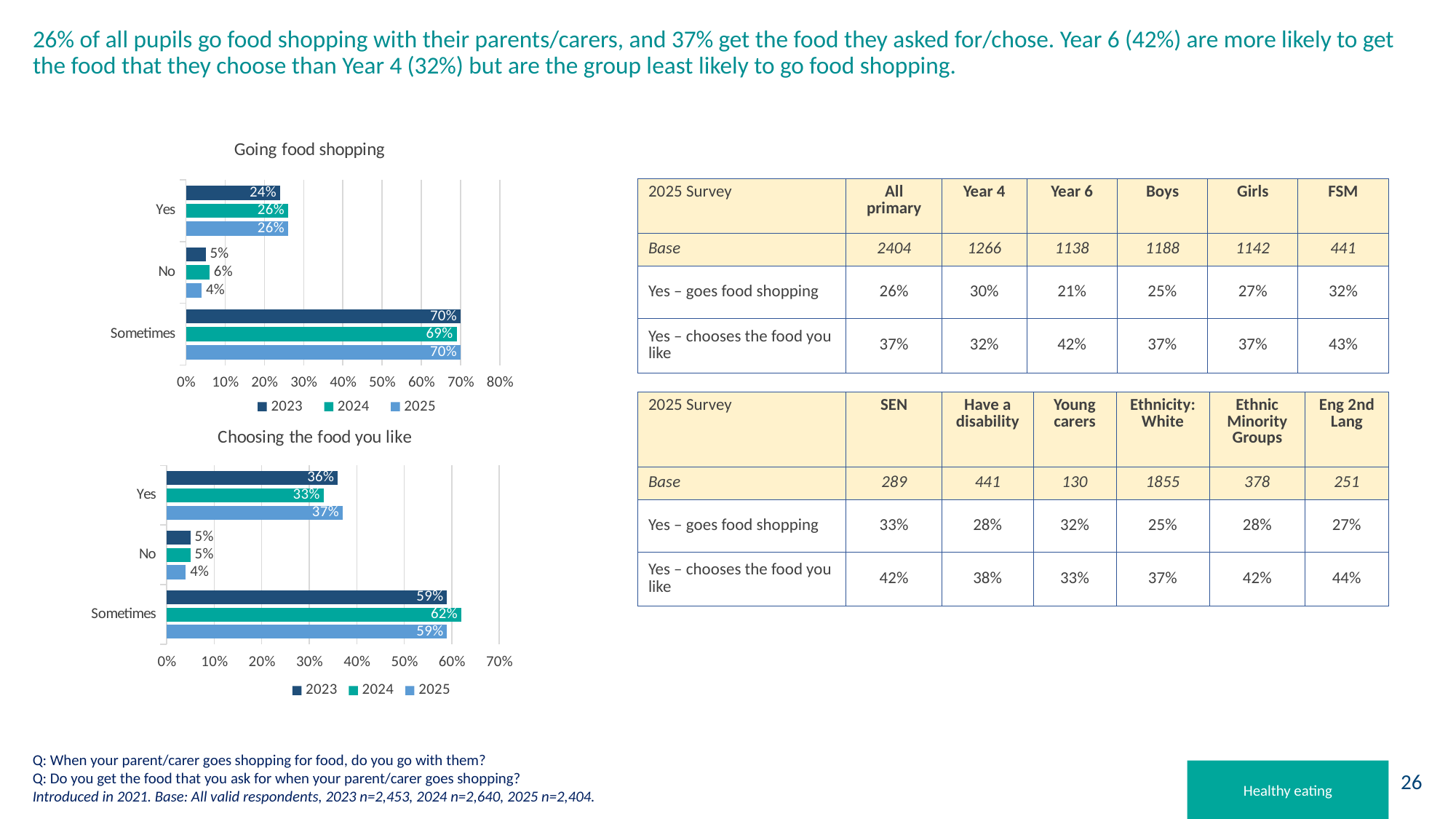
In the 'Going food shopping' chart, what is the value for 'No' in 2024? 6% In the 'Choosing the food you like' chart, what is the difference between the 2025 and 2024 values for 'Yes'? 4% In the 'Choosing the food you like' chart, which category has the lowest value in 2025? No How many categories are shown on the 'Choosing the food you like' chart? 3 What kind of chart is the 'Going food shopping' chart? Bar chart In the 'Choosing the food you like' chart, what is the value for 'Yes' in 2023? 36% In the 'Going food shopping' chart, what is the value for 'Yes' in 2025? 26% In the 'Choosing the food you like' chart, what is the value for 'Sometimes' in 2024? 62% In the 'Going food shopping' chart, which category has the highest value in 2023? Sometimes In the 'Going food shopping' chart, which is larger: the 2023 value for 'Yes' or the 2024 value for 'Yes'? 2024 How many series does the legend of the 'Going food shopping' chart list? 3 What is the title of the lower chart on the slide? Choosing the food you like